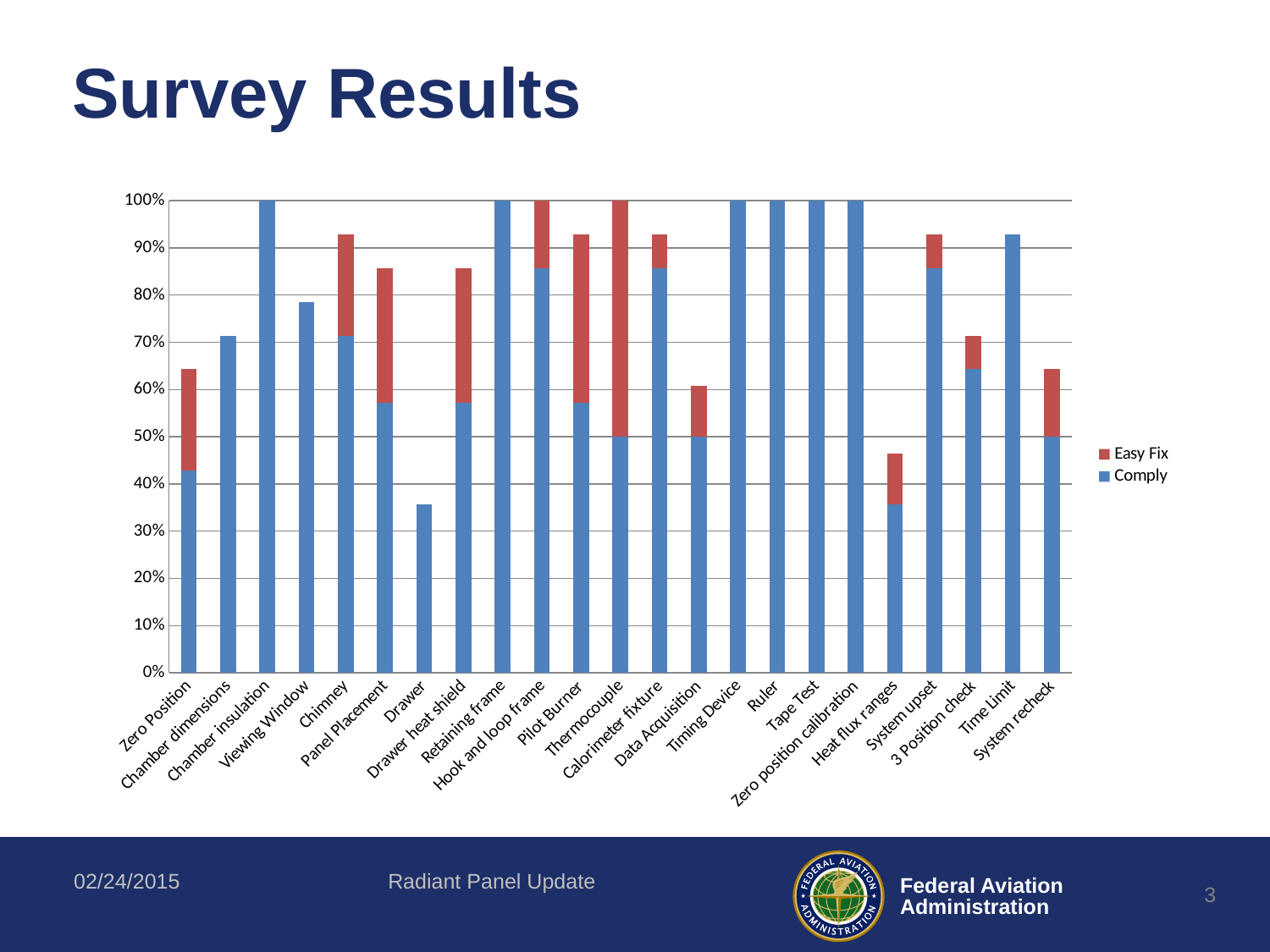
Which has the taller bar, Viewing Window or Drawer? Viewing Window What is the Comply value for Thermocouple? 50% How many series does the legend list? 2 Is the value for Viewing Window greater or less than 70%? greater What is the Comply value for Chamber insulation? 100% Is the value for Drawer greater or less than 40%? less What kind of chart is shown on the slide? stacked bar chart What are the two series named in the legend? Easy Fix and Comply Which has the taller total bar, Chimney or Panel Placement? Chimney Which category has the lowest total bar height? Drawer How many categories are shown on the x axis? 23 Is the total bar for Heat flux ranges greater or less than 50%? less